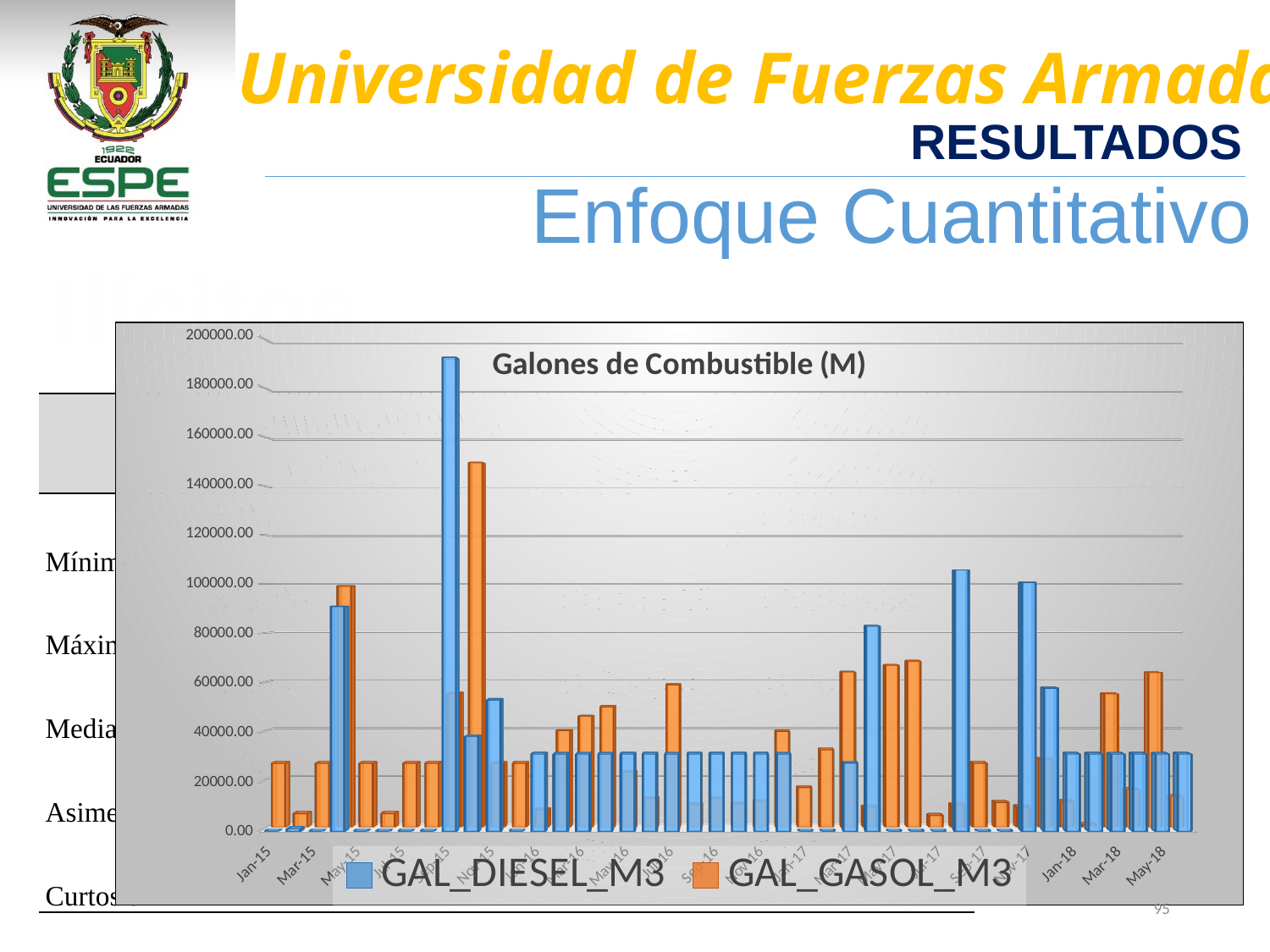
Is the tallest GAL_GASOL_M3 bar greater or less than 140000.00? greater Is the tallest GAL_GASOL_M3 bar greater or less than 160000.00? less Which series is shown in orange in the chart? GAL_GASOL_M3 How many series does the chart's legend list? 2 What kind of chart is shown on the slide? bar chart What is the title of the chart? Galones de Combustible (M) Is the tallest GAL_DIESEL_M3 bar greater or less than 180000.00? greater What is the highest value shown on the chart's vertical axis? 200000.00 Which series has the single tallest bar in the chart, GAL_DIESEL_M3 or GAL_GASOL_M3? GAL_DIESEL_M3